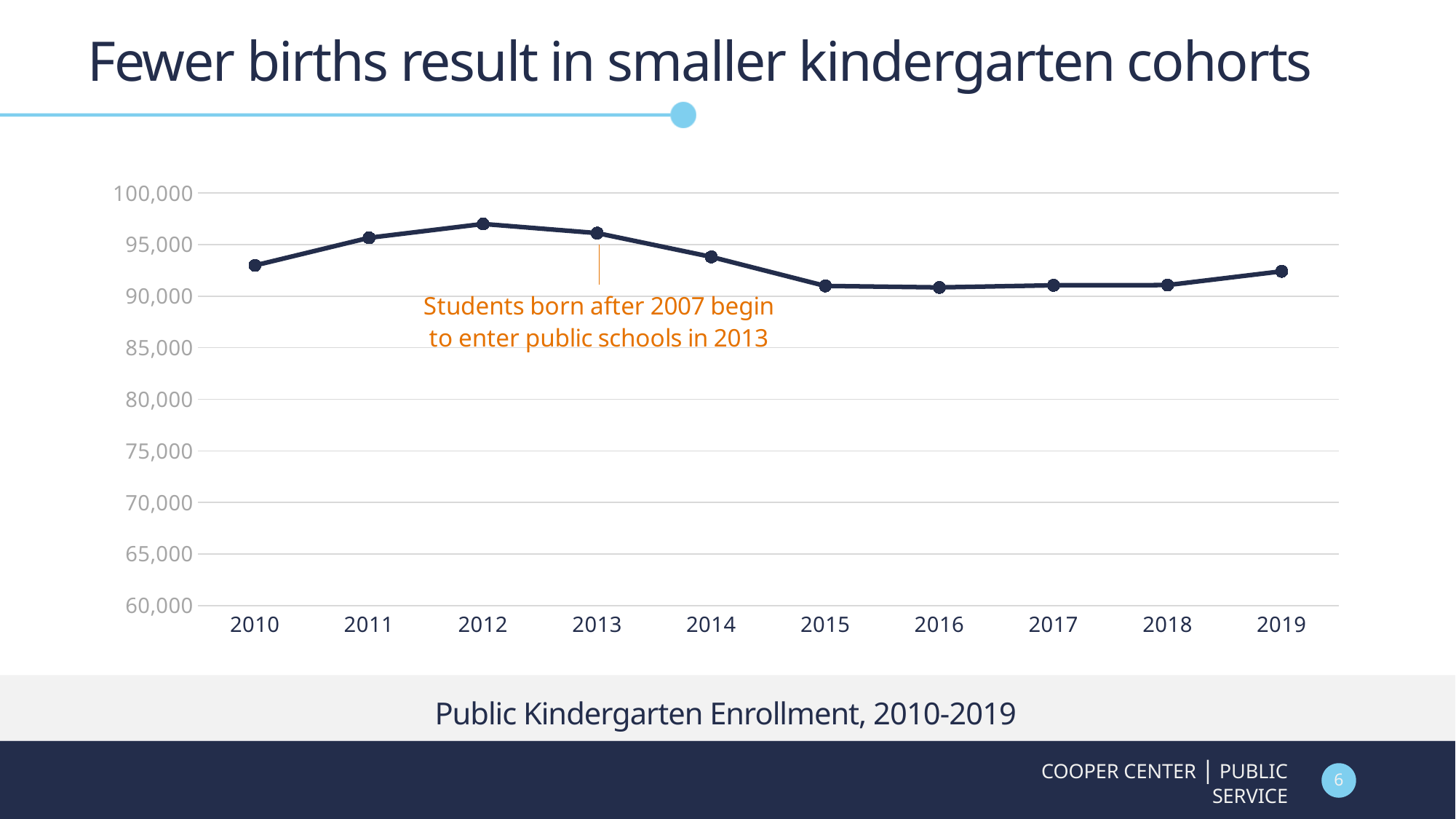
How many years are plotted on the x axis of the chart? 10 Which year has higher enrollment, 2012 or 2015? 2012 Is the enrollment value for 2019 greater or less than 95,000? less In which year is public kindergarten enrollment highest? 2012 Is the enrollment value for 2014 greater or less than 95,000? less Does enrollment rise or fall from 2012 to 2016? fall What kind of chart is shown on the slide? line chart What is the title shown beneath the chart? Public Kindergarten Enrollment, 2010-2019 Is the enrollment value for 2015 greater or less than 90,000? greater Which year has higher enrollment, 2011 or 2014? 2011